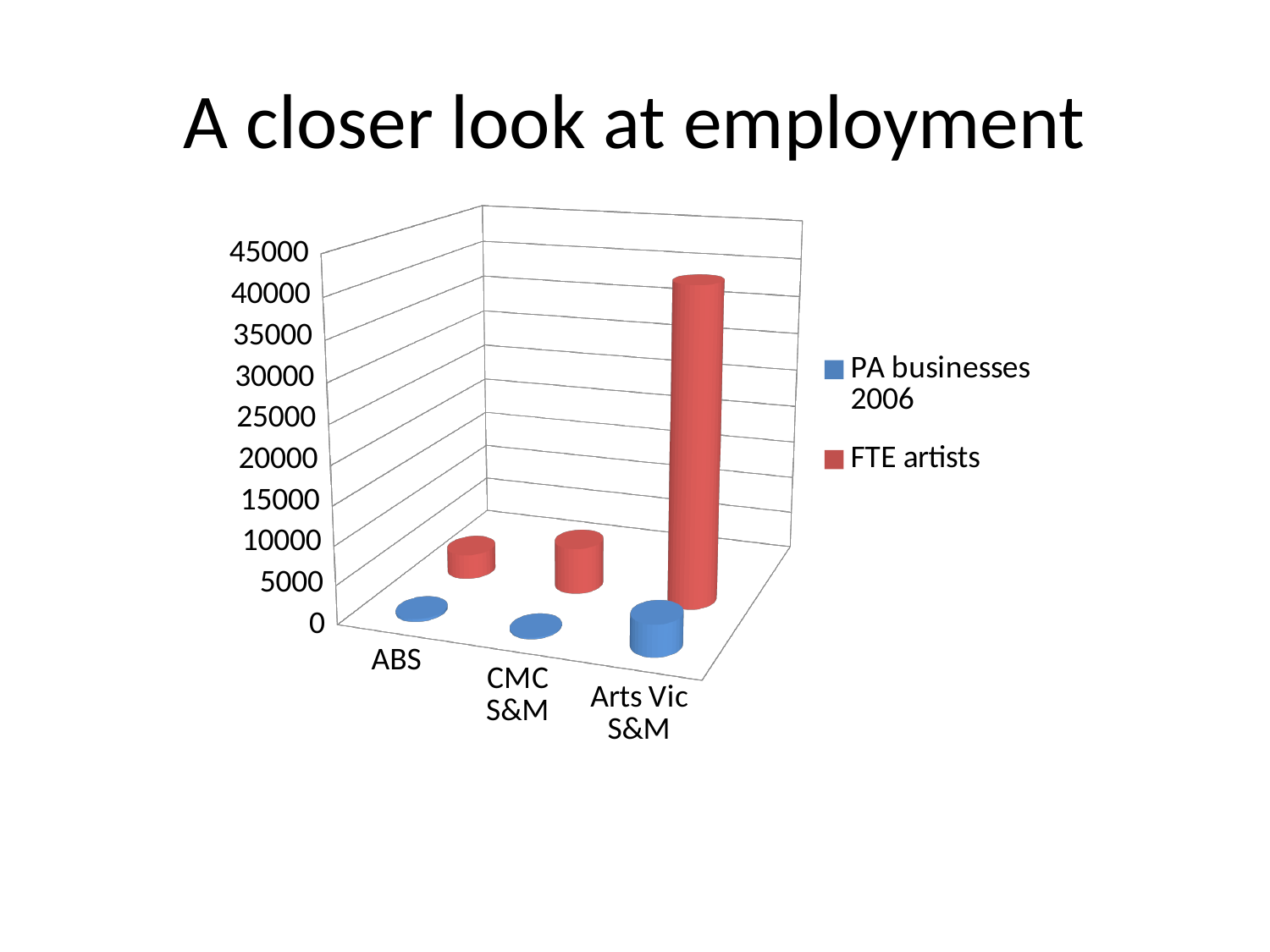
What colour represents the FTE artists series in the chart? red How many series does the chart's legend list? 2 Which category has the highest value for FTE artists? Arts Vic S&M For Arts Vic S&M, which series has the larger value, PA businesses 2006 or FTE artists? FTE artists Which is larger, the FTE artists value for Arts Vic S&M or for CMC S&M? Arts Vic S&M Is the value for FTE artists at CMC S&M greater or less than 20000? less What is the title of the slide? A closer look at employment How many categories are shown on the x axis of the chart? 3 What kind of chart is shown on the slide? bar chart Is the value for FTE artists at Arts Vic S&M greater or less than 30000? greater Is the value for PA businesses 2006 at ABS greater or less than 5000? less For ABS, which series has the larger value, PA businesses 2006 or FTE artists? FTE artists